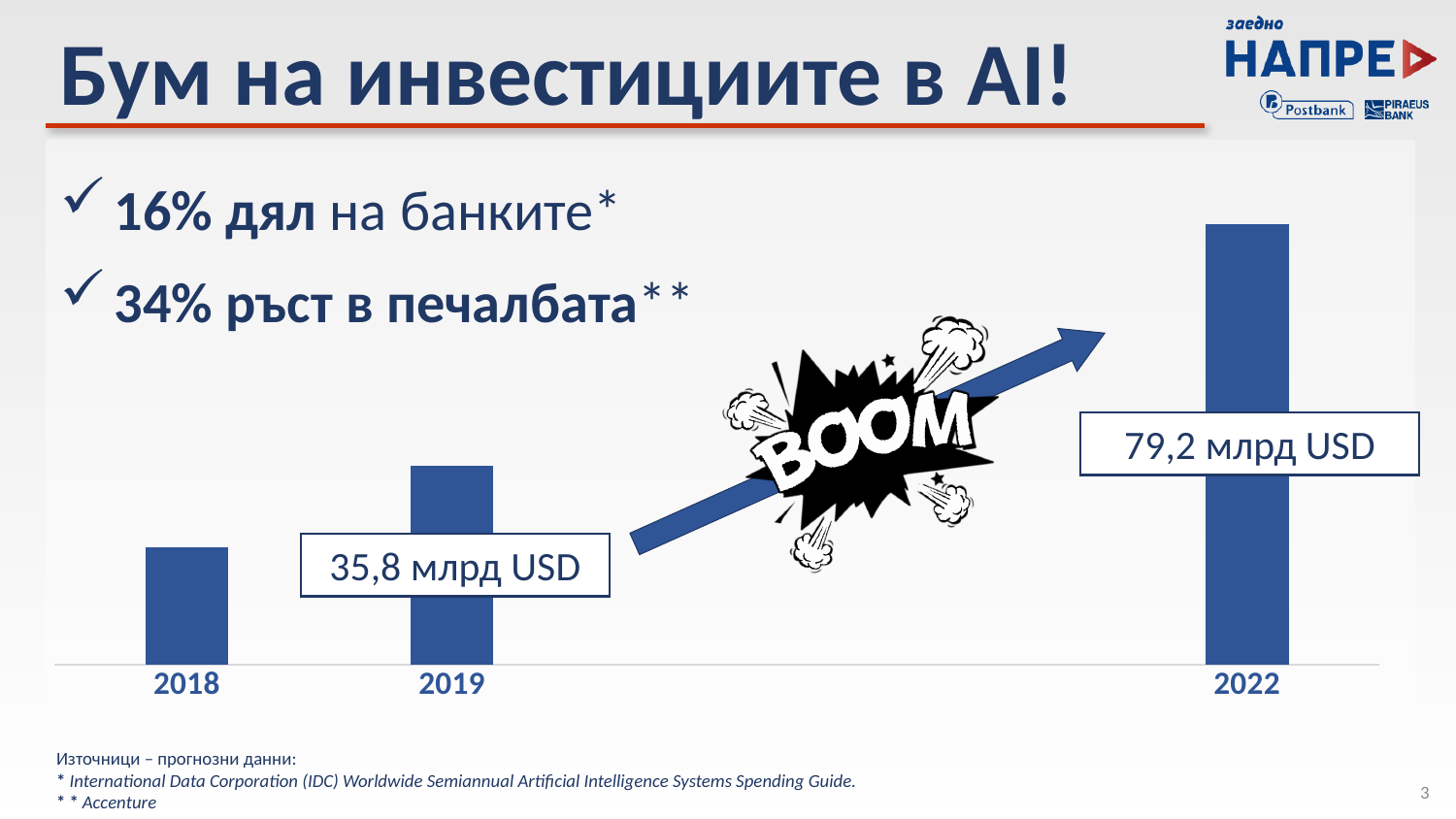
What is the title of the slide containing the chart? Бум на инвестициите в AI! What is the value shown for 2022? 79,2 млрд USD Which year's bar has no value label printed on the chart? 2018 How many years are shown on the chart? 3 What is the difference between the values for 2022 and 2019? 43,4 млрд USD Which year has the lowest bar? 2018 What is the value shown for 2019? 35,8 млрд USD Do the values rise or fall from 2018 to 2022? rise Which year has the highest bar? 2022 What kind of chart is shown on the slide? bar chart Which is larger, the value for 2019 or the value for 2022? 2022 Which is larger, the bar for 2018 or the bar for 2019? 2019